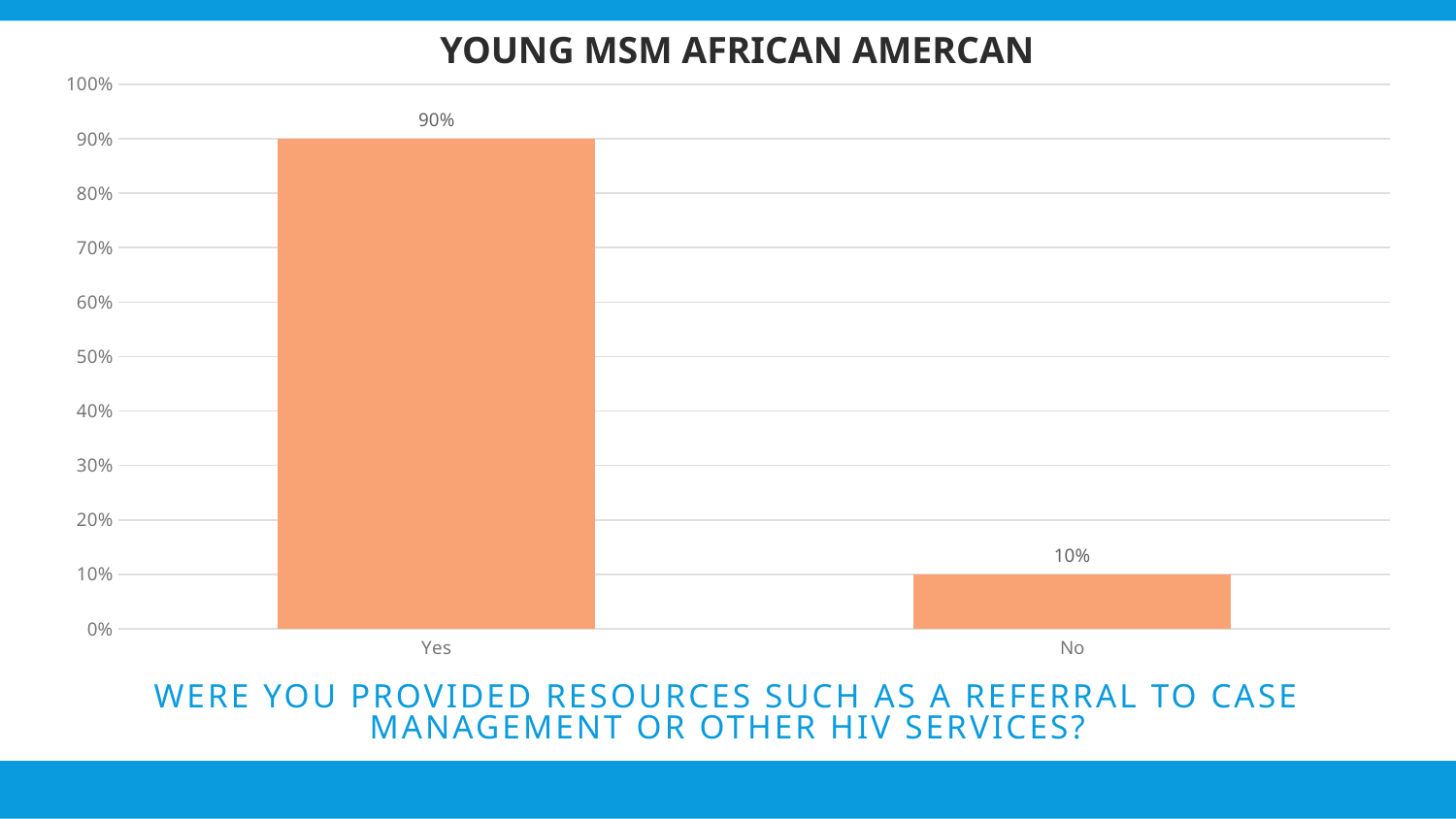
Which category has the highest value? Yes Which category has the lowest value? No What kind of chart is shown on the slide? bar chart How many categories are shown on the x axis? 2 What is the highest value shown on the y axis? 100% What is the value for No? 10% Which is larger, the value for Yes or the value for No? Yes What is the value for Yes? 90% What is the difference between the values for Yes and No? 80% Is the value for No greater or less than 20%? less Is the value for Yes greater or less than 50%? greater What is the title of the chart? YOUNG MSM AFRICAN AMERCAN